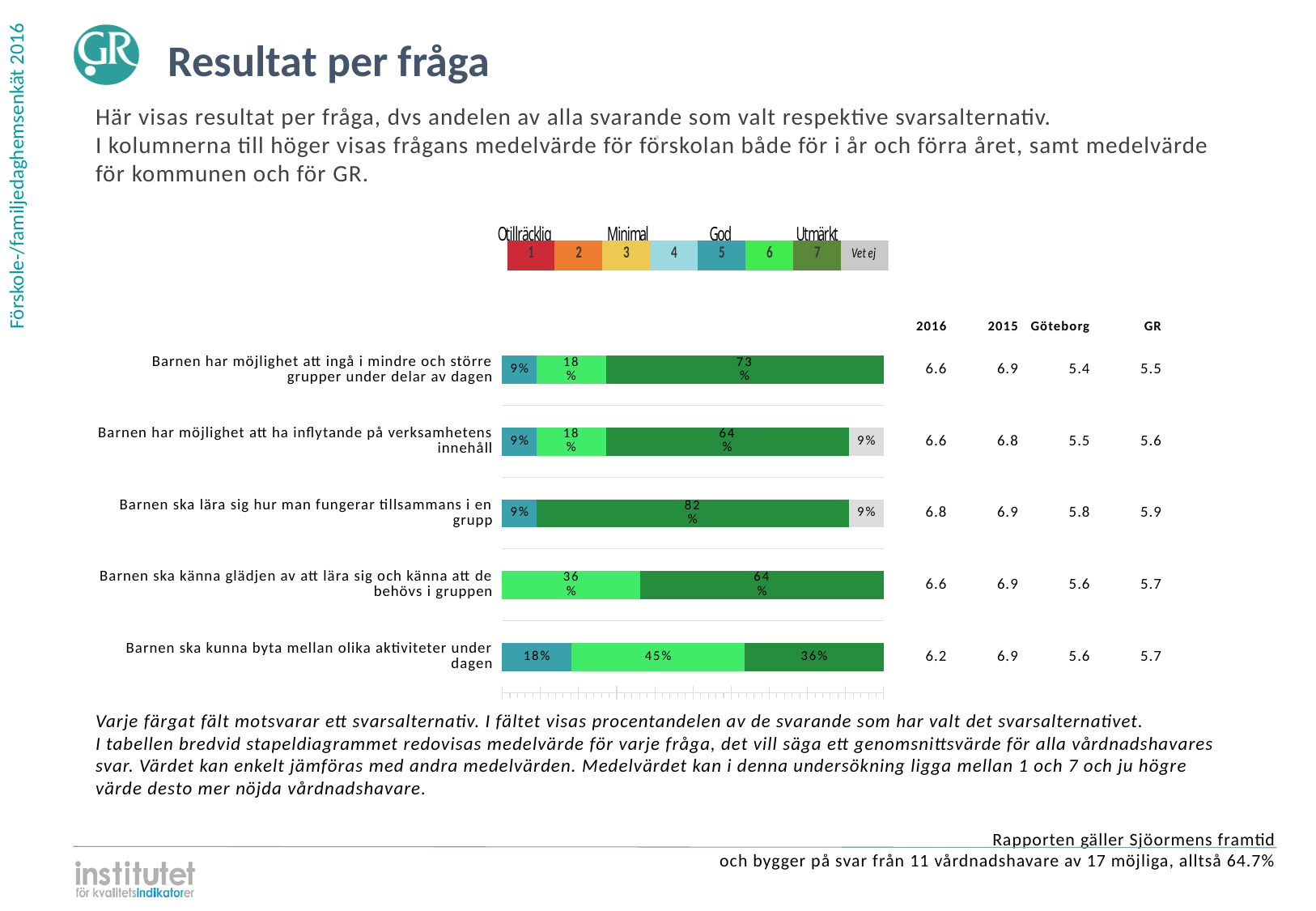
Which question has the lowest share of answer 7 (dark green)? Barnen ska kunna byta mellan olika aktiviteter under dagen What is the 2016 mean value shown for "Barnen ska kunna byta mellan olika aktiviteter under dagen"? 6.2 What is the difference between the answer 6 share and the answer 7 share for "Barnen ska känna glädjen av att lära sig och känna att de behövs i gruppen"? 28% What percentage chose answer 6 (light green) for "Barnen ska kunna byta mellan olika aktiviteter under dagen"? 45% Is the answer 5 (teal) share larger for "Barnen ska kunna byta mellan olika aktiviteter under dagen" or for "Barnen har möjlighet att ingå i mindre och större grupper under delar av dagen"? Barnen ska kunna byta mellan olika aktiviteter under dagen What is the "Vet ej" share for "Barnen har möjlighet att ha inflytande på verksamhetens innehåll"? 9% What kind of chart is used to show the results per question? Stacked bar chart What percentage chose answer 7 (dark green) for "Barnen ska lära sig hur man fungerar tillsammans i en grupp"? 82% How many answer categories does the legend above the chart list? 8 What percentage of respondents chose answer 7 (dark green) for "Barnen har möjlighet att ingå i mindre och större grupper under delar av dagen"? 73% How many questions (categories) are shown in the bar chart? 5 Which question has the highest share of answer 7 (dark green)? Barnen ska lära sig hur man fungerar tillsammans i en grupp